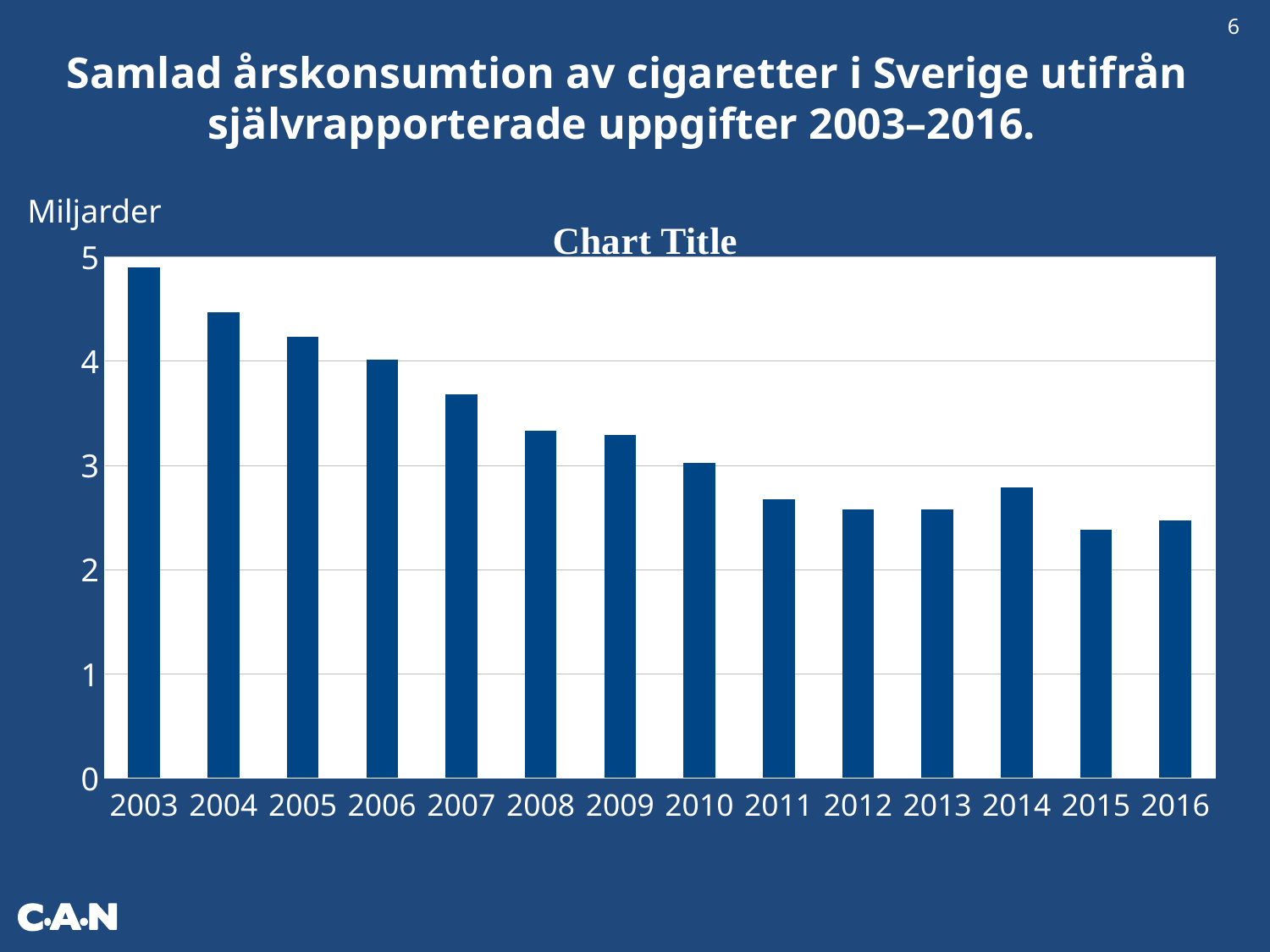
Is the value for 2007 greater or less than 4? less What kind of chart is shown on the slide? bar chart Is the value for 2015 greater or less than 2? greater Do the values generally rise or fall from 2003 to 2016? fall Which is larger, the value for 2004 or the value for 2014? 2004 How many years are plotted on the x axis? 14 Is the value for 2008 greater or less than 3? greater Which year has the lowest bar? 2015 What unit label is shown above the y axis? Miljarder Which year has the highest bar? 2003